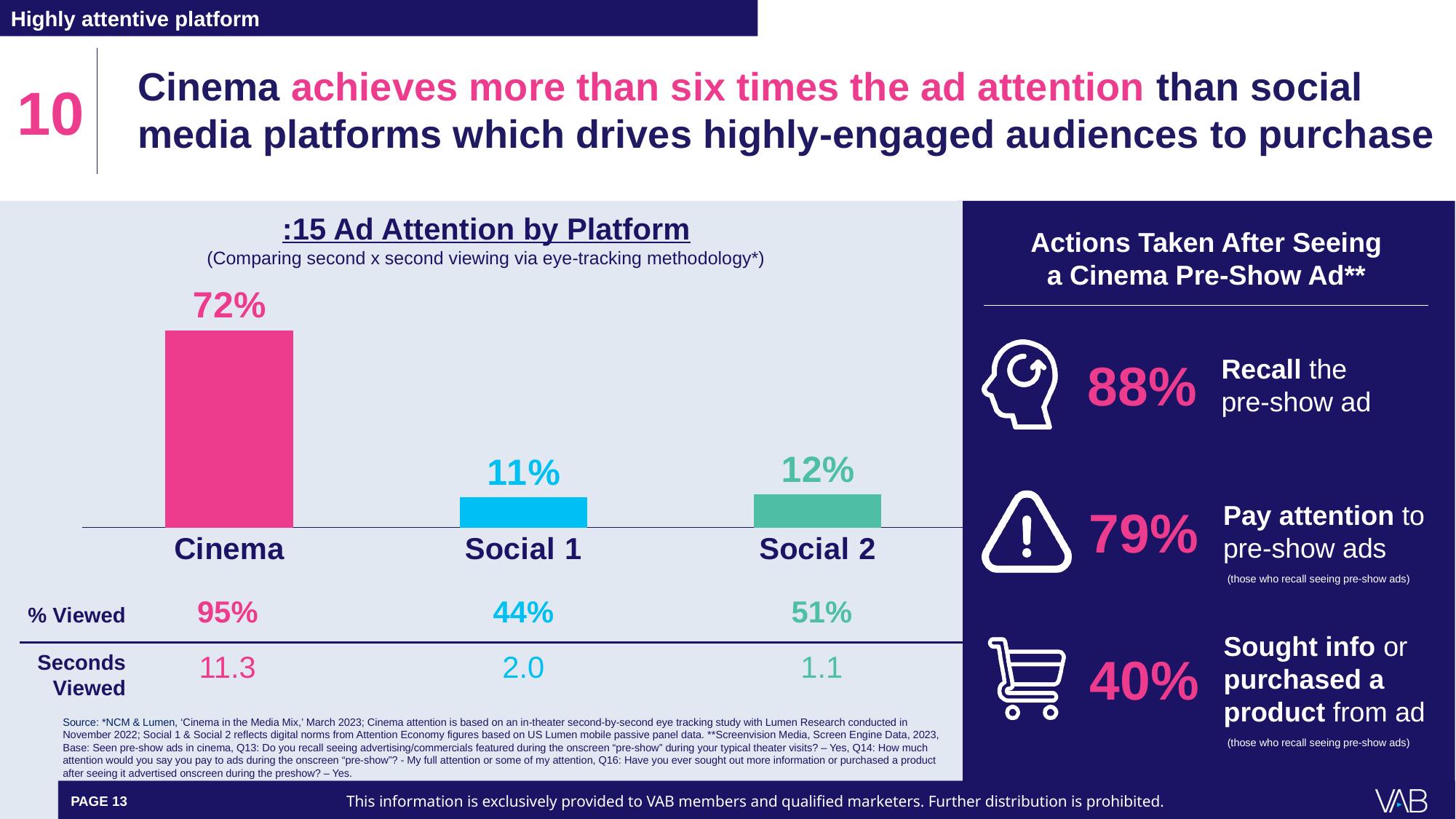
What is the % Viewed value for Social 1 in the table below the chart? 44% What colour is the Cinema bar in the :15 Ad Attention by Platform chart? Pink How many platforms are shown in the :15 Ad Attention by Platform chart? 3 What is the :15 ad attention value for Social 1? 11% Which platform has the highest :15 ad attention? Cinema What is the difference in :15 ad attention between Cinema and Social 2? 60 percentage points Which platform has the lowest :15 ad attention? Social 1 What is the :15 ad attention value for Cinema? 72% What is the :15 ad attention value for Social 2? 12% What type of chart is :15 Ad Attention by Platform? Bar chart Which has higher :15 ad attention, Social 1 or Social 2? Social 2 What is the Seconds Viewed value for Cinema in the table below the chart? 11.3